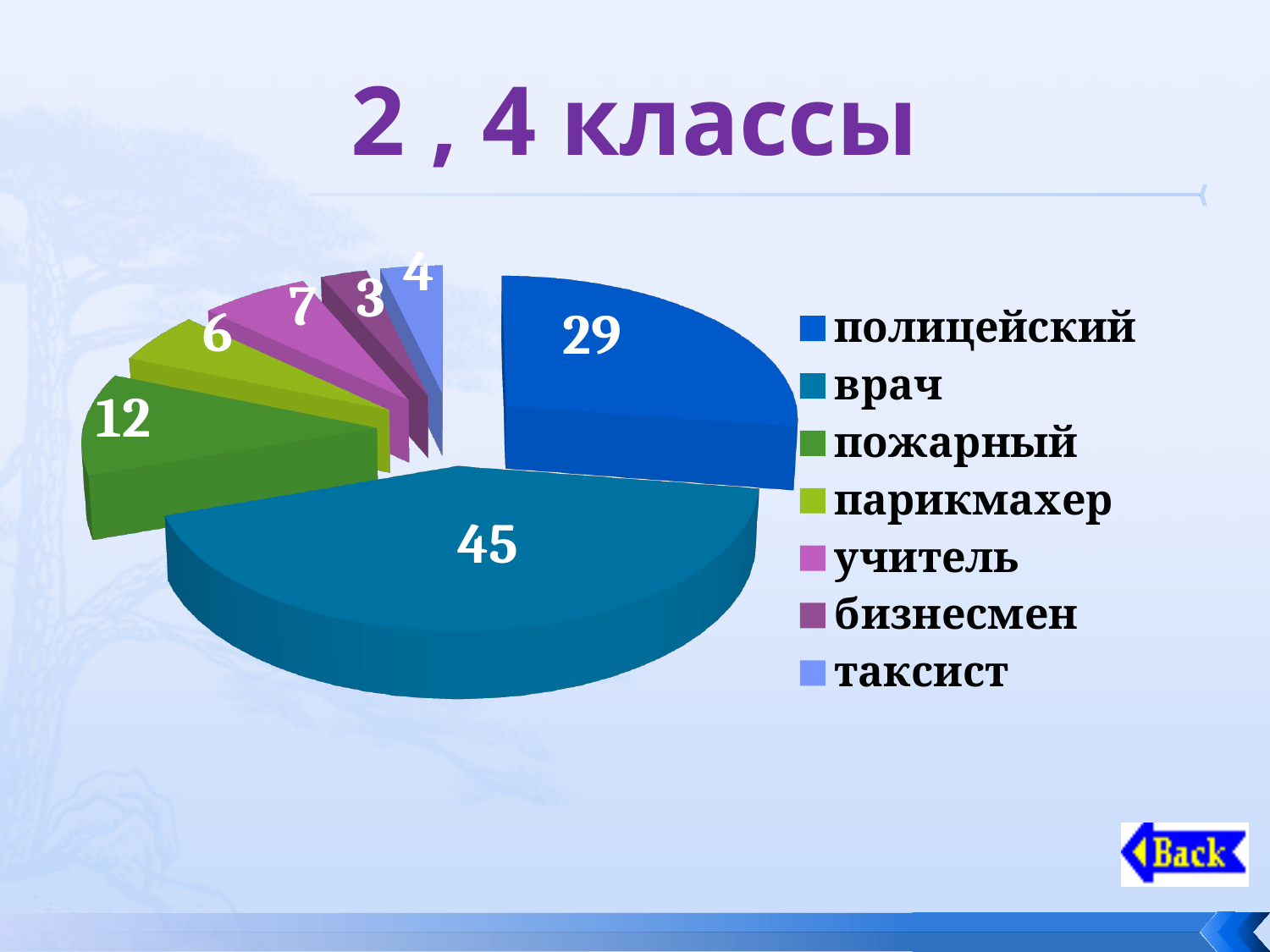
What is the difference between the values for врач and полицейский? 16 What kind of chart is shown on the slide? pie chart Which category has the smallest slice? бизнесмен What is the value for полицейский? 29 What is the value for таксист? 4 How many categories does the pie chart have? 7 What is the value for пожарный? 12 What is the value for врач? 45 What is the total of all the slices in the pie chart? 106 Which is larger, the value for учитель or the value for парикмахер? учитель What is the title of the slide containing the chart? 2 , 4 классы Which category has the largest slice? врач